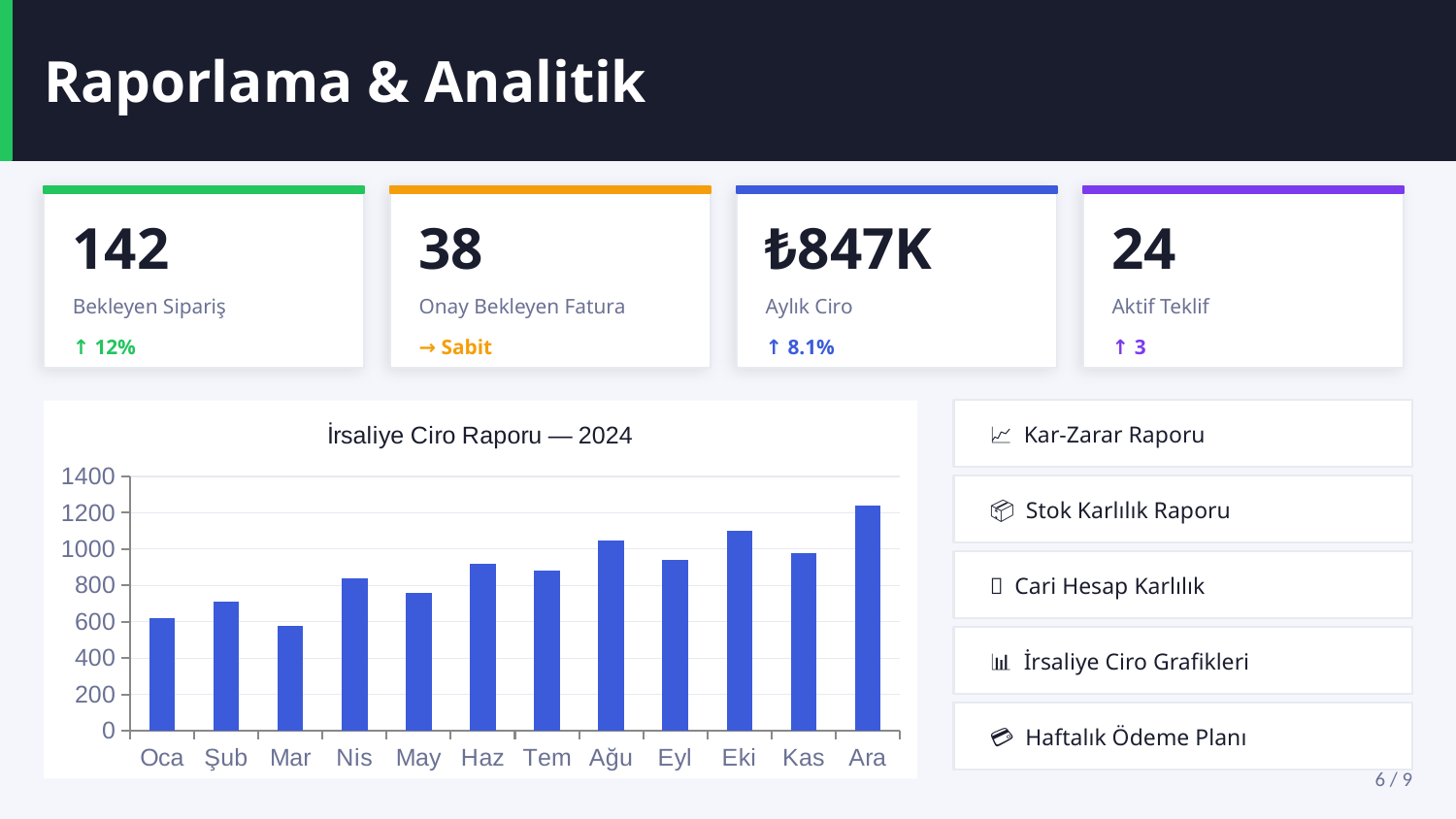
Do the values generally rise or fall from Oca to Ara? rise Is the value for Oca greater or less than 800? less Is the value for Ara greater or less than 1200? greater What kind of chart is shown on the slide? bar chart How many months are plotted on the x axis of the chart? 12 Which month has the highest bar in the chart? Ara Which is larger, the value for Nis or the value for May? Nis Which month has the lowest bar in the chart? Mar Is the value for Eki greater or less than 1000? greater Which is larger, the value for Ağu or the value for Eyl? Ağu What is the title of the chart? İrsaliye Ciro Raporu — 2024